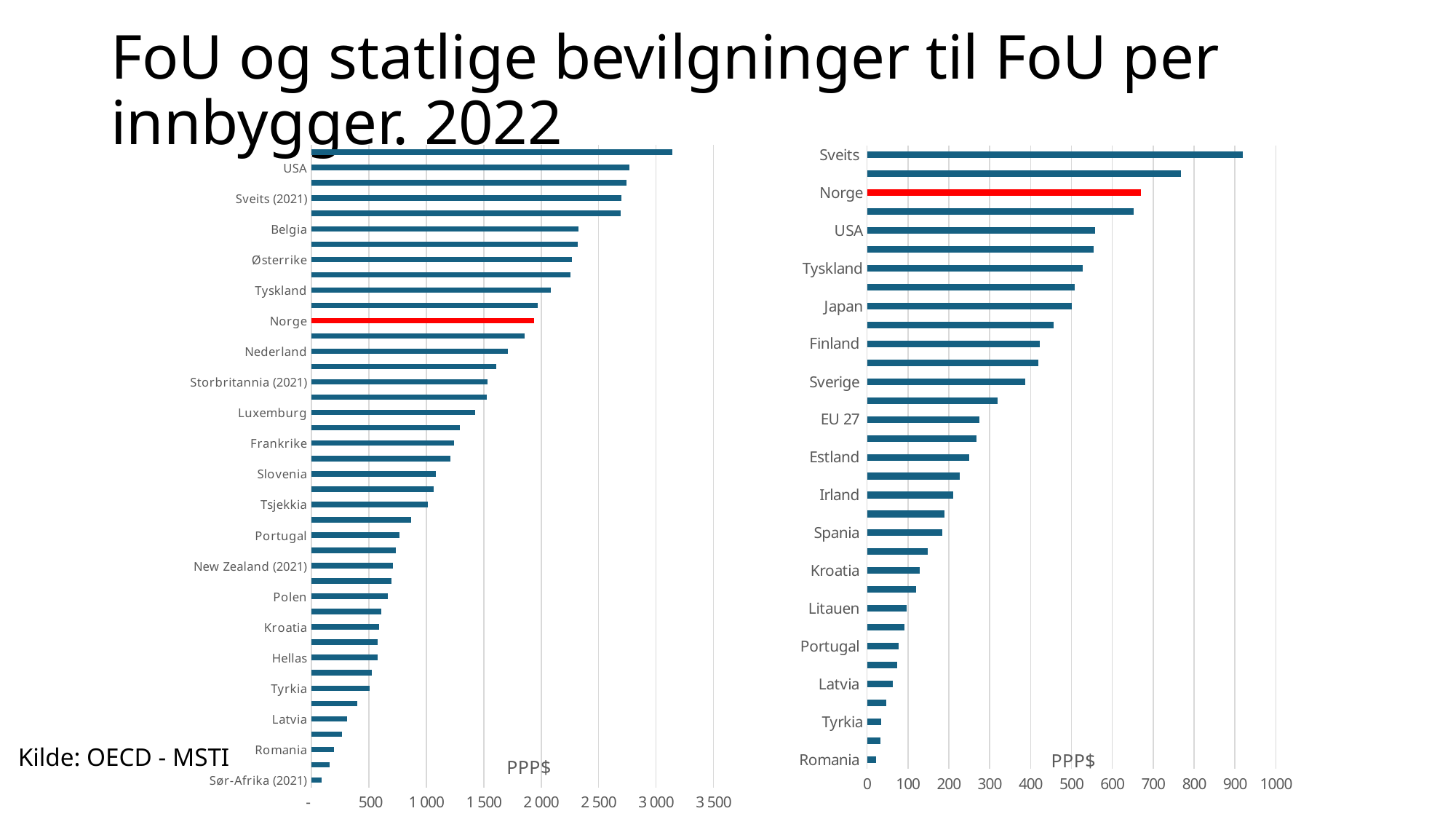
In the left chart, which is larger, the value for USA or the value for Norge? USA In the right chart, which is larger, the value for Sveits or the value for Norge? Sveits In the right chart, is the value for Romania greater or less than 100? less In the left chart, which labelled country has the lowest value? Sør-Afrika (2021) In the right chart, is the value for Norge greater or less than 600? greater In the left chart, is the value for USA greater or less than 2 500? greater In the right chart, which labelled country has the highest value? Sveits What kind of chart is the left chart on the slide? bar chart In the right chart, do the bar values rise or fall from top to bottom? fall Which country's bar is highlighted in red in both charts? Norge